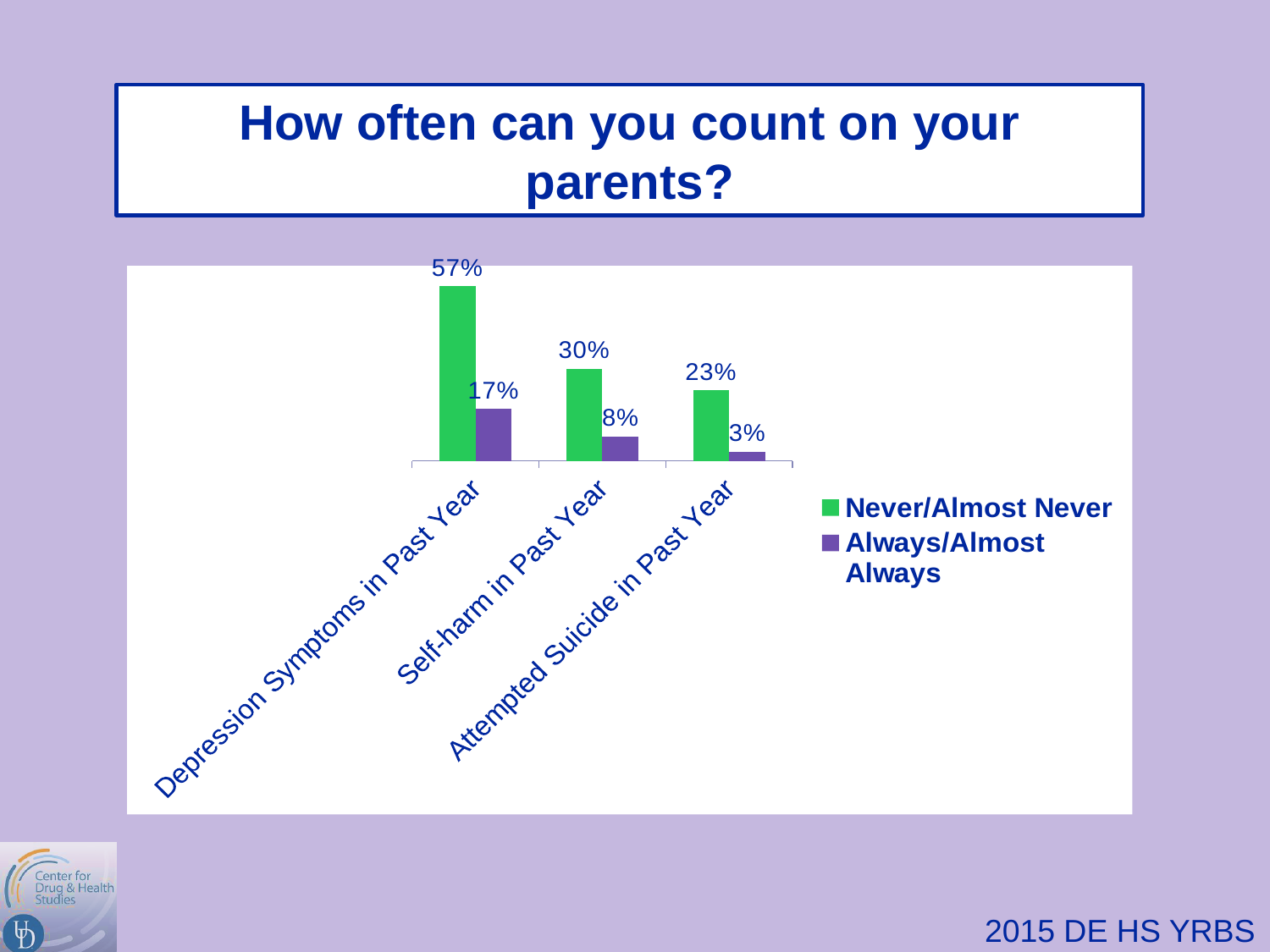
Which colour represents the Always/Almost Always series? Purple Which category has the lowest Always/Almost Always value? Attempted Suicide in Past Year Which category has the highest Never/Almost Never value? Depression Symptoms in Past Year What is the value for Never/Almost Never for Depression Symptoms in Past Year? 57% Which is larger: the Never/Almost Never value for Attempted Suicide in Past Year or the Always/Almost Always value for Depression Symptoms in Past Year? Never/Almost Never for Attempted Suicide in Past Year What is the value for Always/Almost Always for Self-harm in Past Year? 8% How many categories are shown on the x axis? 3 What kind of chart is shown on the slide? Bar chart What is the value for Never/Almost Never for Self-harm in Past Year? 30% How many series does the legend list? 2 What is the difference between the Never/Almost Never and Always/Almost Always values for Depression Symptoms in Past Year? 40% What is the value for Always/Almost Always for Attempted Suicide in Past Year? 3%